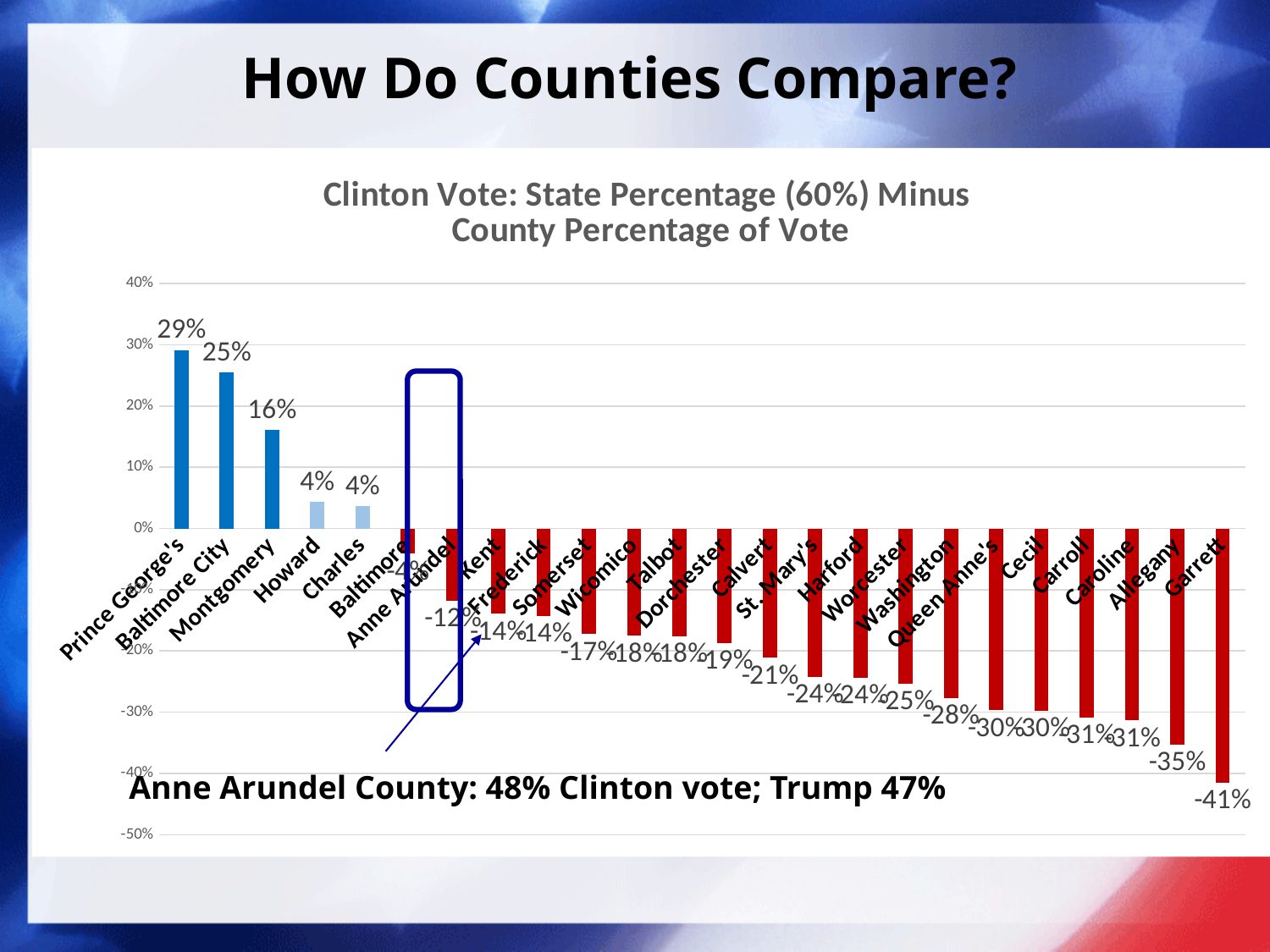
Which county has the lowest value? Garrett Which county has the highest value? Prince George's Is the value for Baltimore greater or less than -10%? greater What is the value for Montgomery? 16% Which is larger, the value for Montgomery or the value for Howard? Montgomery What is the value for Anne Arundel? -12% How many counties are shown on the x axis? 24 What kind of chart is shown? Bar chart What is the value for Garrett? -41% What is the difference between the values for Prince George's and Baltimore City? 4 percentage points What is the value for Prince George's? 29% Do the values rise or fall moving left to right along the x axis? Fall